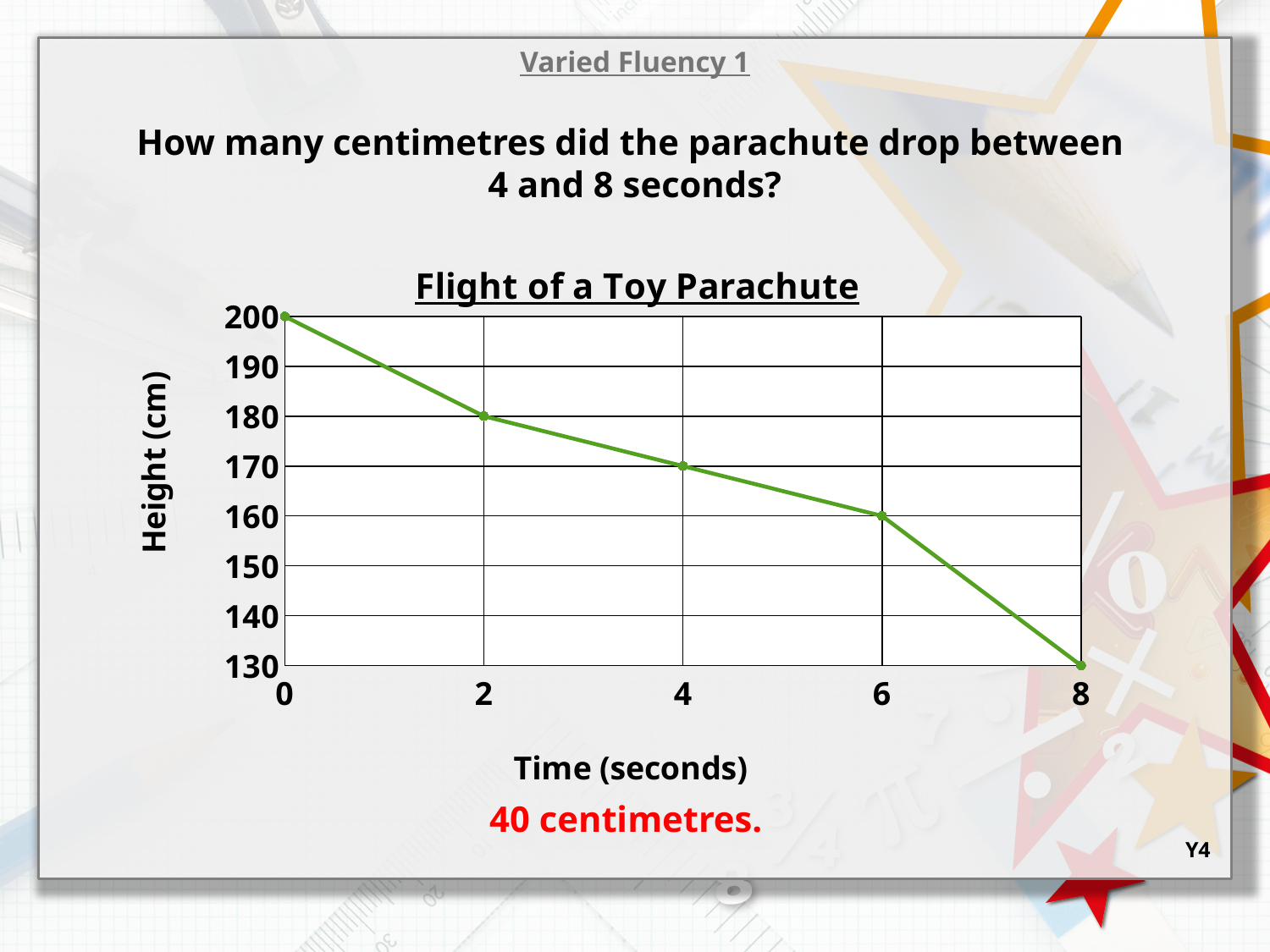
What is the title of the chart? Flight of a Toy Parachute What is the height of the parachute at 4 seconds? 170 How much did the height drop between 0 and 2 seconds? 20 What is the height of the parachute at 0 seconds? 200 At which time is the parachute's height highest? 0 What is the height of the parachute at 6 seconds? 160 What is the height of the parachute at 2 seconds? 180 What is the height of the parachute at 8 seconds? 130 At which time is the parachute's height lowest? 8 Does the height rise or fall as time increases along the x axis? fall What kind of chart is shown on the slide? line chart How many data points are plotted on the line? 5